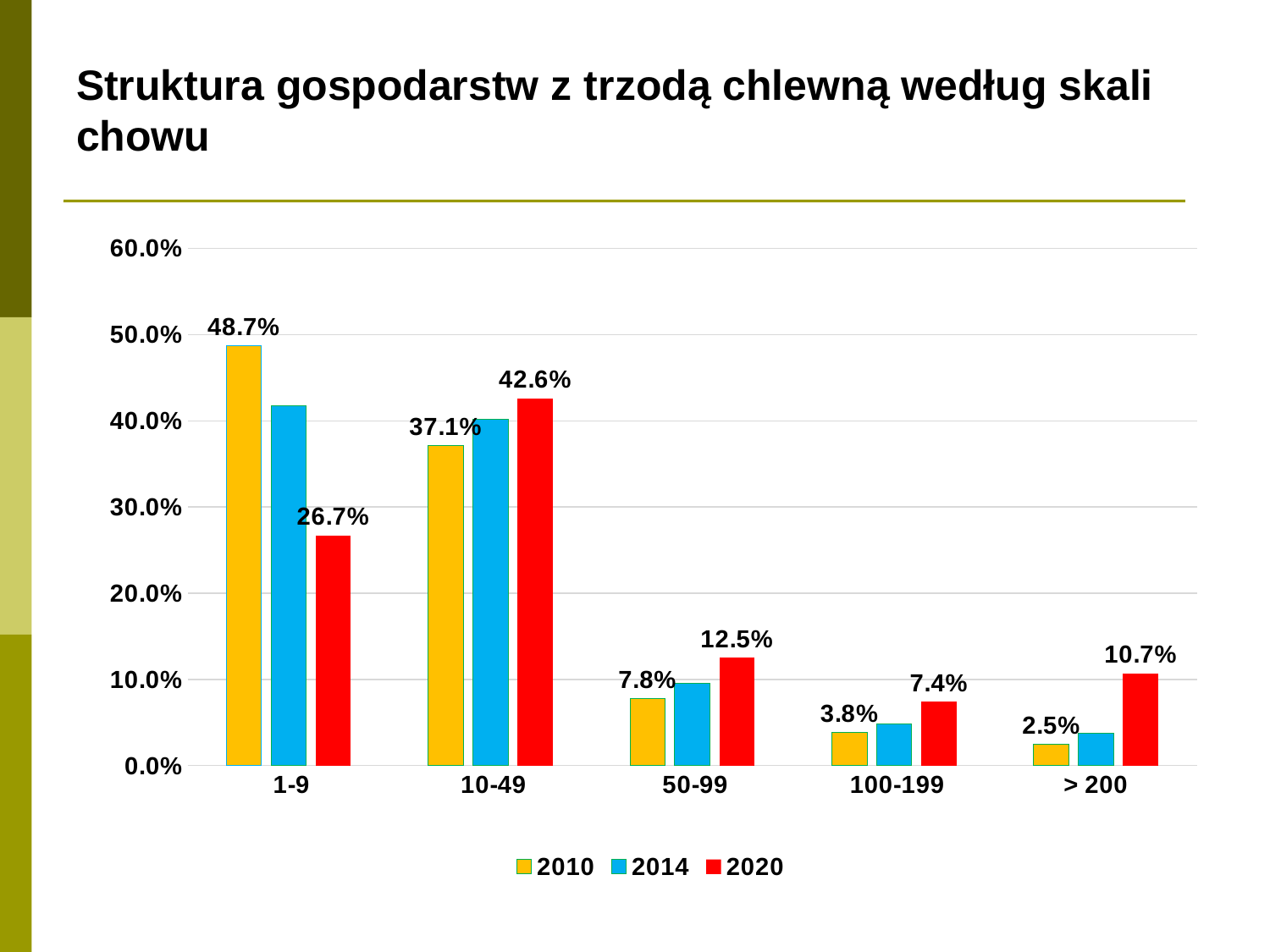
How many categories are shown on the x axis? 5 What is the value for 2010 in the 100-199 category? 3.8% What kind of chart is shown on the slide? bar chart What is the value for 2010 in the 1-9 category? 48.7% Is the value for 2014 in the 1-9 category greater or less than 40.0%? greater What is the value for 2020 in the 10-49 category? 42.6% Which category has the highest value for the 2010 series? 1-9 What is the value for 2020 in the > 200 category? 10.7% Which is larger in the 50-99 category, the 2010 value or the 2020 value? 2020 What is the difference between the 2010 and 2020 values in the 1-9 category? 22.0% How many series does the legend list? 3 Which category has the lowest value for the 2020 series? 100-199